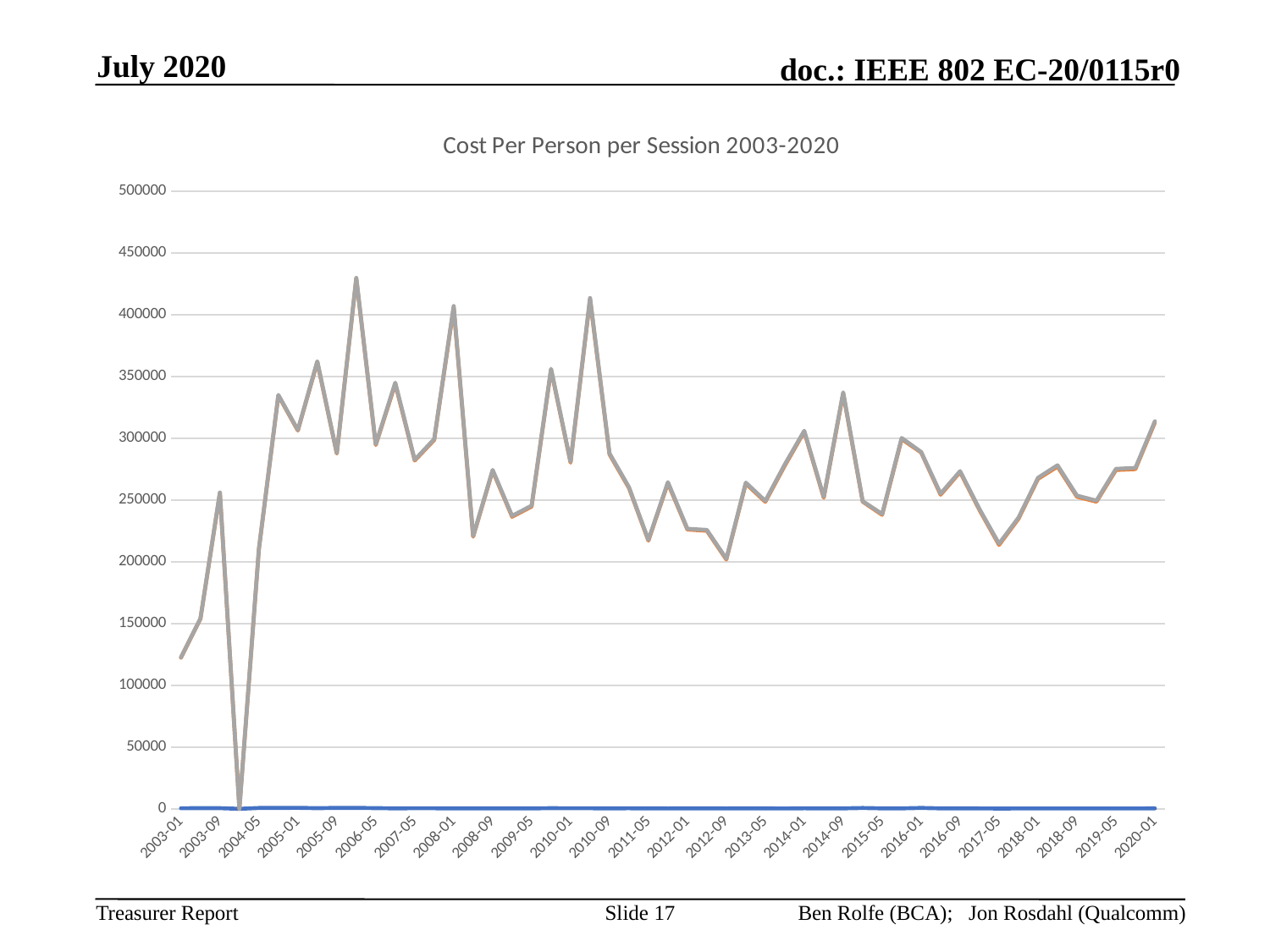
Which has the higher value, 2005-01 or 2003-01? 2005-01 Is the value for 2020-01 greater or less than 300000? greater Is the value for 2003-01 greater or less than 150000? less What kind of chart is shown on the slide? line chart Is the value for 2012-09 greater or less than 250000? less What is the title of the chart? Cost Per Person per Session 2003-2020 Which labelled point on the x axis has the lowest value on the chart? 2003-01 Does the value rise or fall from 2010-09 to 2011-05? fall